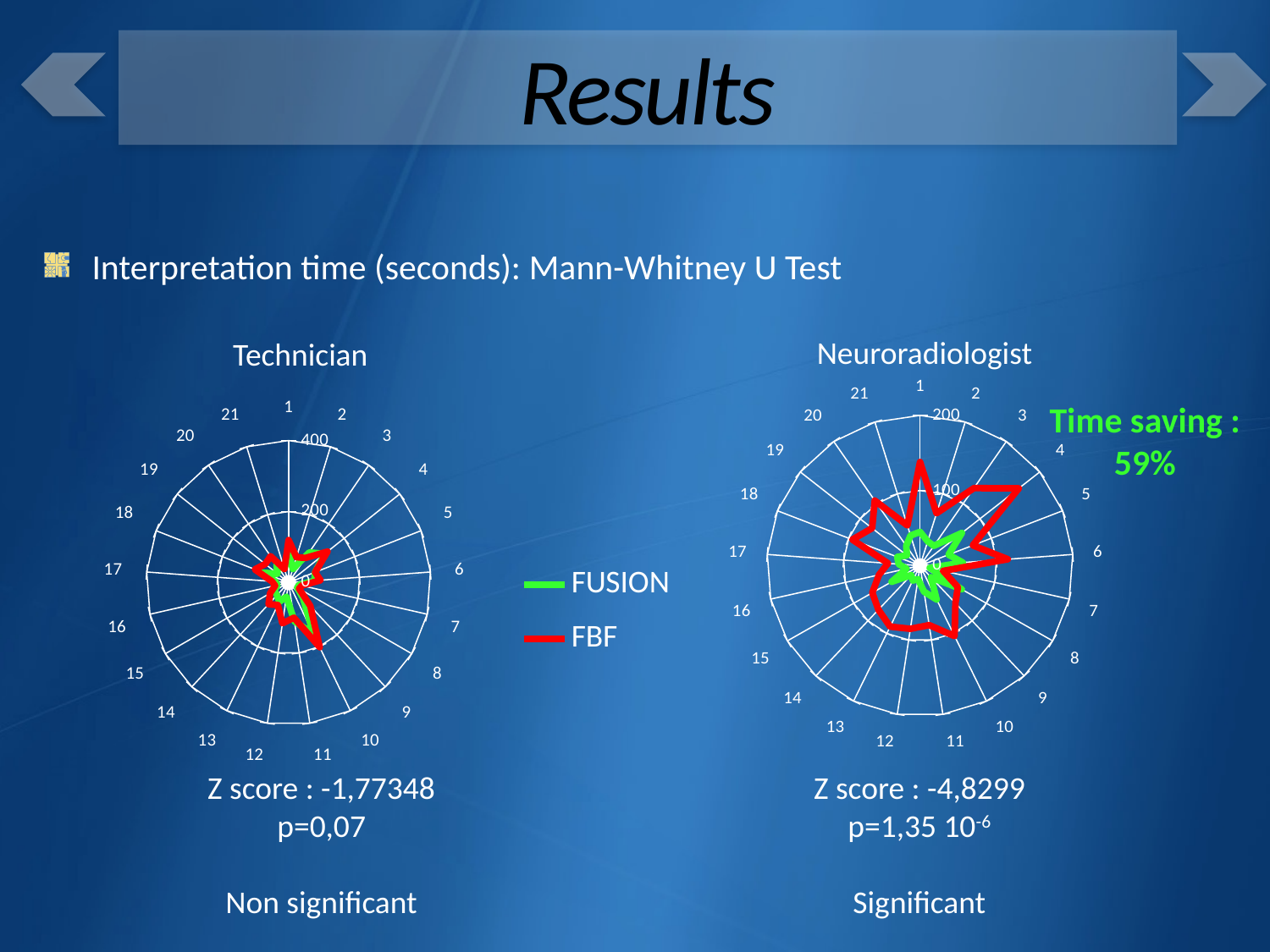
In the Neuroradiologist chart, is the FUSION value for category 4 greater or less than 100? less In the Technician chart, is the FBF value for category 8 greater or less than 200? less How many categories are plotted around the Neuroradiologist chart? 21 What kind of chart is the Technician chart? radar chart What is the highest axis tick value shown on the Technician chart? 400 In the Neuroradiologist chart, is the FBF value for category 4 greater or less than 100? greater How many series does the legend list? 2 In the Neuroradiologist chart, which series has the larger value for category 4, FUSION or FBF? FBF What are the two series named in the legend? FUSION and FBF